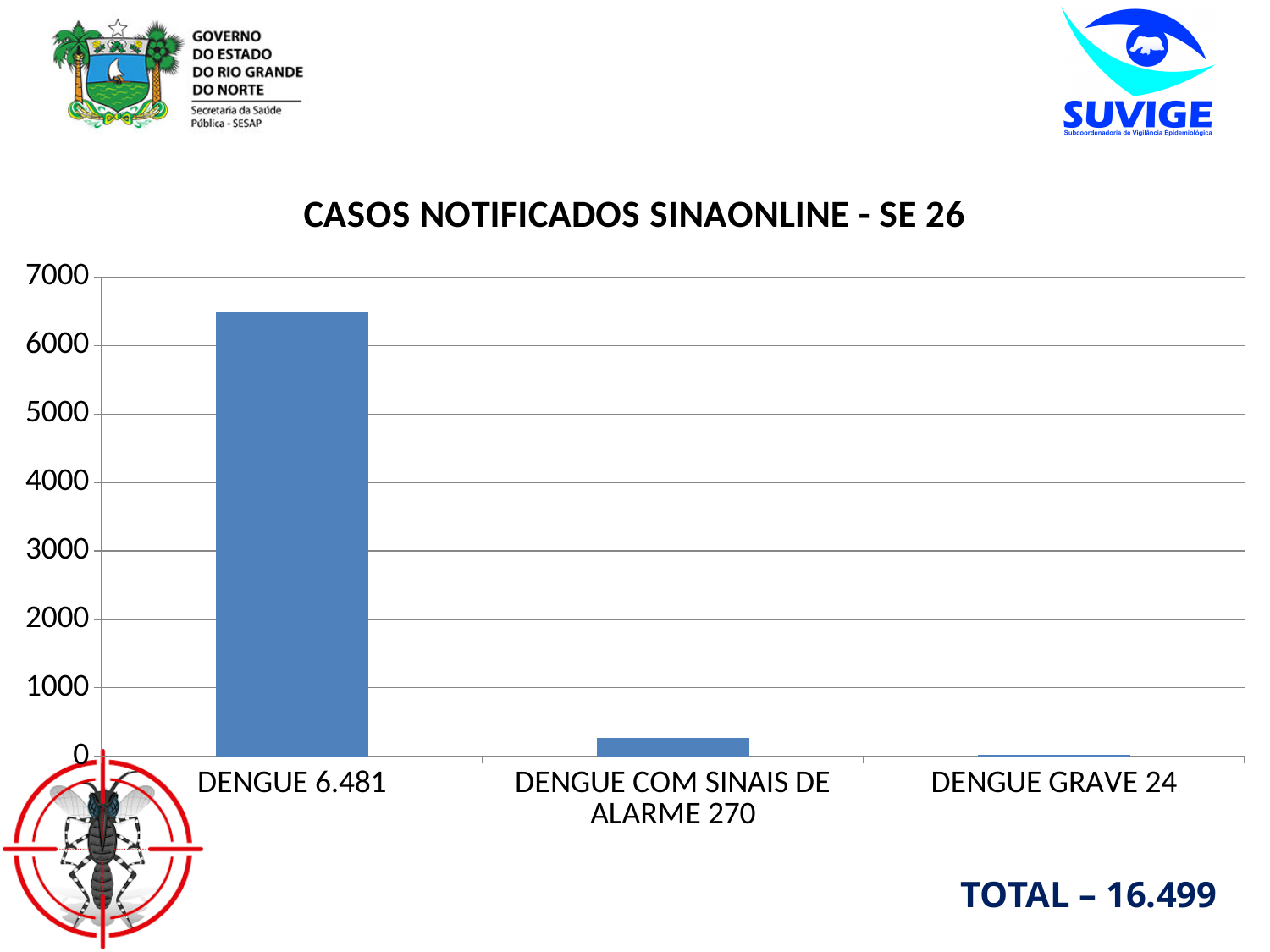
What is the number of cases shown for DENGUE GRAVE? 24 What type of chart is shown on the slide? bar chart What is the number of cases shown for DENGUE COM SINAIS DE ALARME? 270 Which category has the lowest number of cases? DENGUE GRAVE Which category has the highest number of cases? DENGUE What is the difference between the cases for DENGUE and DENGUE COM SINAIS DE ALARME? 6.211 What is the number of cases shown for DENGUE? 6.481 What is the difference between the cases for DENGUE COM SINAIS DE ALARME and DENGUE GRAVE? 246 What is the title of the chart? CASOS NOTIFICADOS SINAONLINE - SE 26 Which has more cases, DENGUE COM SINAIS DE ALARME or DENGUE GRAVE? DENGUE COM SINAIS DE ALARME How many categories are plotted in the chart? 3 Is the value for DENGUE greater or less than 6000? greater